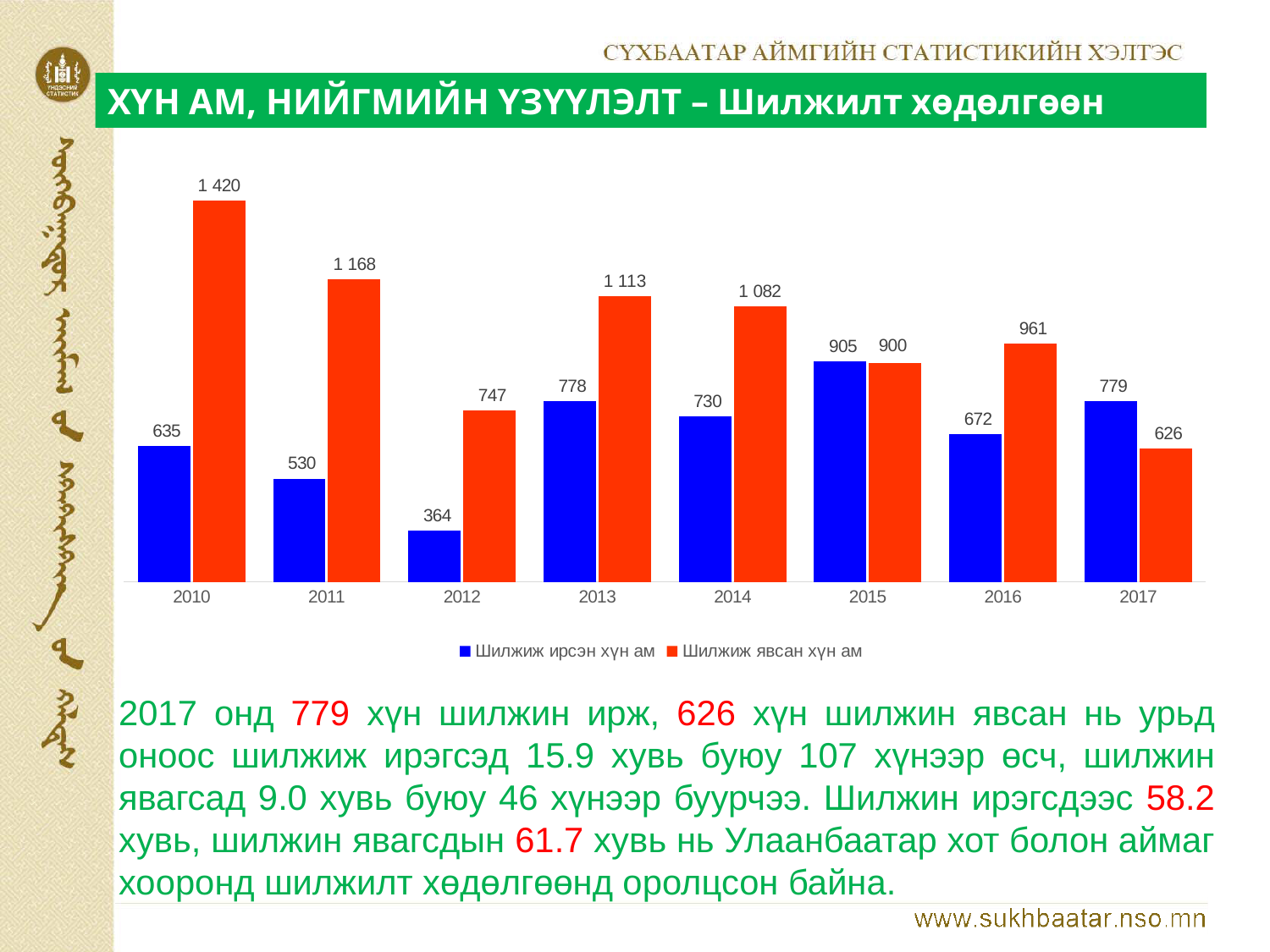
What is the value for Шилжиж ирсэн хүн ам in 2017? 779 In which year is Шилжиж ирсэн хүн ам lowest? 2012 What is the value for Шилжиж явсан хүн ам in 2010? 1 420 What kind of chart is shown on the slide? Bar chart What is the value for Шилжиж ирсэн хүн ам in 2012? 364 Which colour represents Шилжиж явсан хүн ам in the chart? Red In which year is Шилжиж явсан хүн ам highest? 2010 In 2015, which is larger: Шилжиж ирсэн хүн ам or Шилжиж явсан хүн ам? Шилжиж ирсэн хүн ам Does Шилжиж явсан хүн ам rise or fall from 2016 to 2017? Fall How many series does the legend list? 2 What is the difference between Шилжиж явсан хүн ам and Шилжиж ирсэн хүн ам in 2011? 638 How many years are shown on the x axis? 8